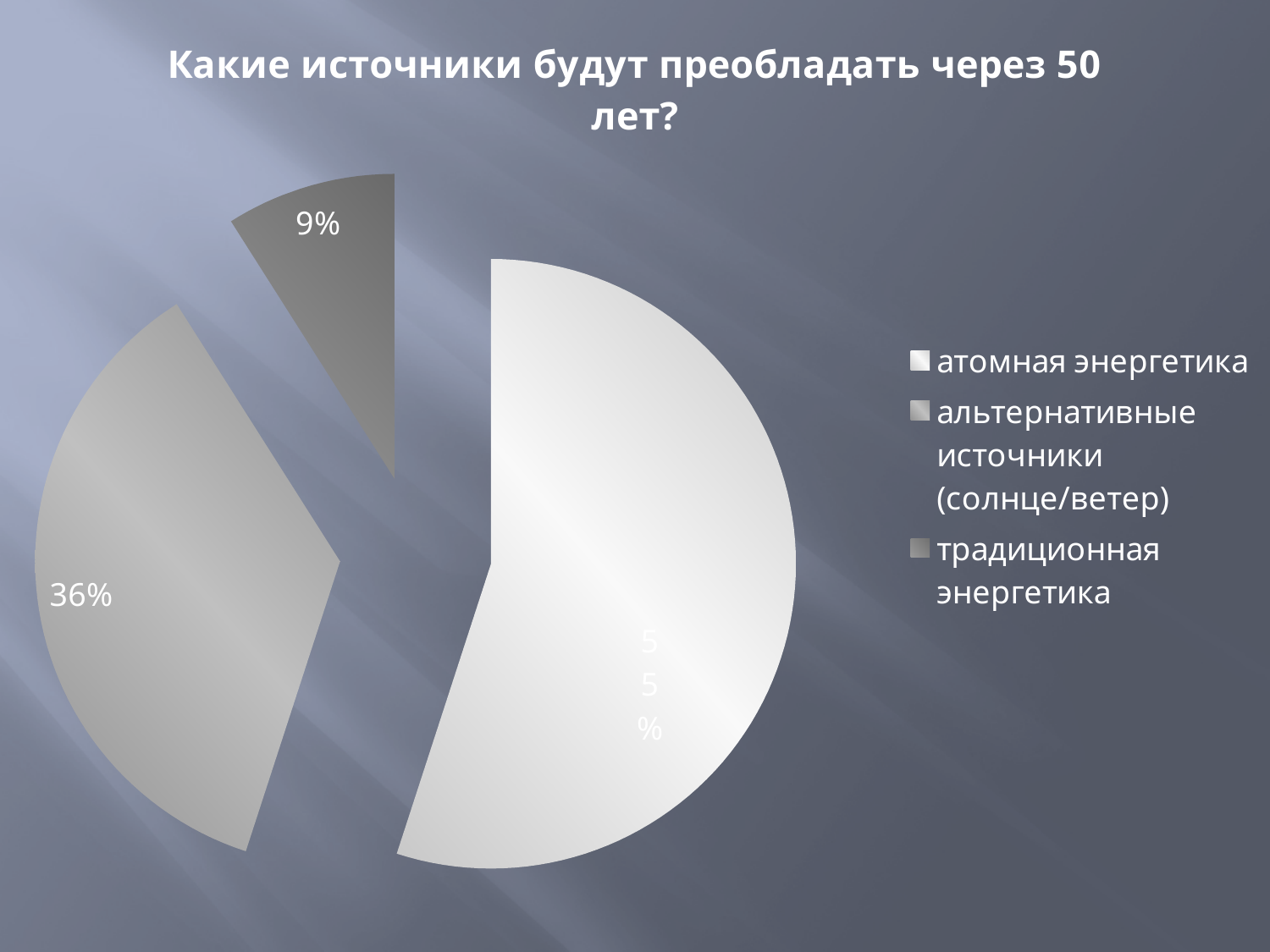
What share of the pie does атомная энергетика have? 55% How many entries does the legend list? 3 What share of the pie does альтернативные источники (солнце/ветер) have? 36% What is the title of the chart? Какие источники будут преобладать через 50 лет? Which is larger: the share of альтернативные источники (солнце/ветер) or традиционная энергетика? альтернативные источники (солнце/ветер) How many slices does the pie chart have? 3 Which category has the smallest slice of the pie? традиционная энергетика What kind of chart is shown on the slide? pie chart What share of the pie does традиционная энергетика have? 9% Which category has the largest slice of the pie? атомная энергетика What is the difference between the shares of альтернативные источники (солнце/ветер) and традиционная энергетика? 27% What is the difference between the shares of атомная энергетика and альтернативные источники (солнце/ветер)? 19%